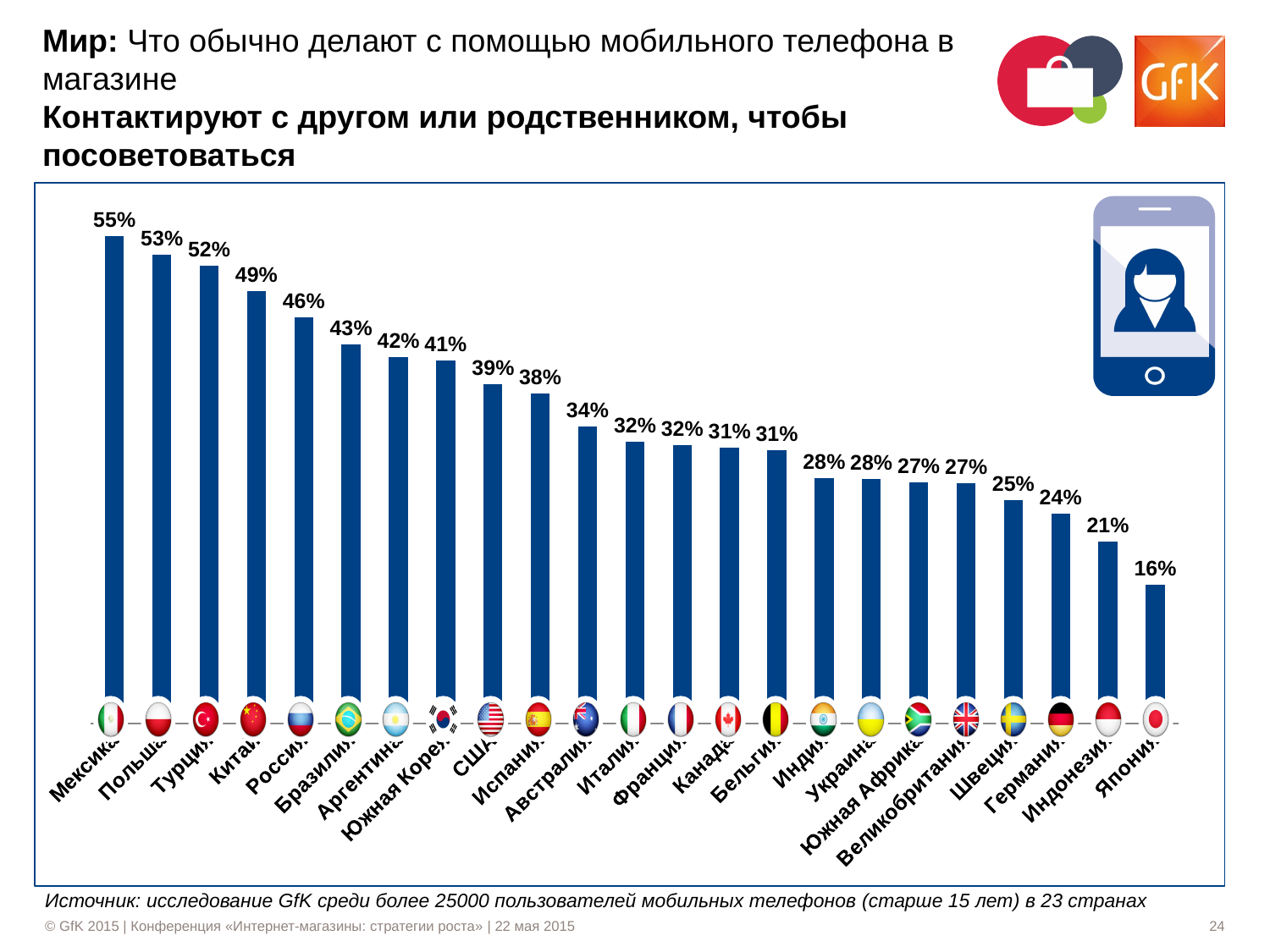
Do the values rise or fall from left to right along the x axis? Fall Which country has the highest value? Мексика What is the value for Россия? 46% How many countries are shown in the chart? 23 What is the difference between the values for Китай and Германия? 25% What kind of chart is shown on the slide? Bar chart What is the value for Великобритания? 27% What is the difference between the values for Мексика and Япония? 39% Which country has the lowest value? Япония What is the value for Мексика? 55% What is the value for Южная Корея? 41% Which is larger, the value for Бразилия or the value for Индия? Бразилия